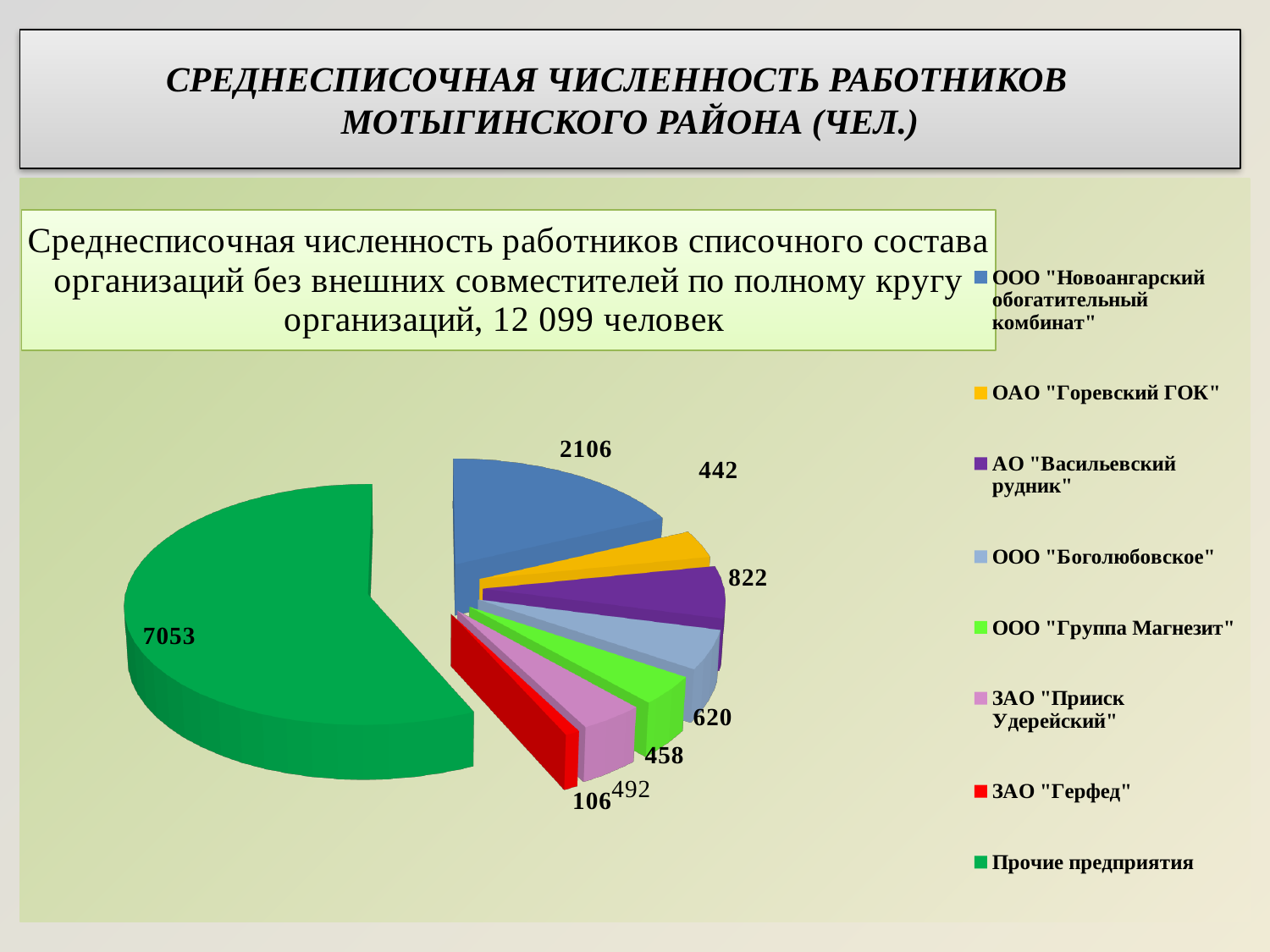
How many entries does the legend list? 8 What is the difference between the values for ООО "Боголюбовское" and ООО "Группа Магнезит"? 162 What is the value for ООО "Новоангарский обогатительный комбинат"? 2106 What kind of chart is shown on the slide? Pie chart Which category has the smallest slice of the pie? ЗАО "Герфед" What is the value for АО "Васильевский рудник"? 822 Which is larger, the value for ОАО "Горевский ГОК" or the value for ООО "Группа Магнезит"? ООО "Группа Магнезит" Which category has the largest slice of the pie? Прочие предприятия How many slices does the pie chart have? 8 What is the value for ЗАО "Герфед"? 106 What is the value for ЗАО "Прииск Удерейский"? 492 What colour is the slice for Прочие предприятия? Green